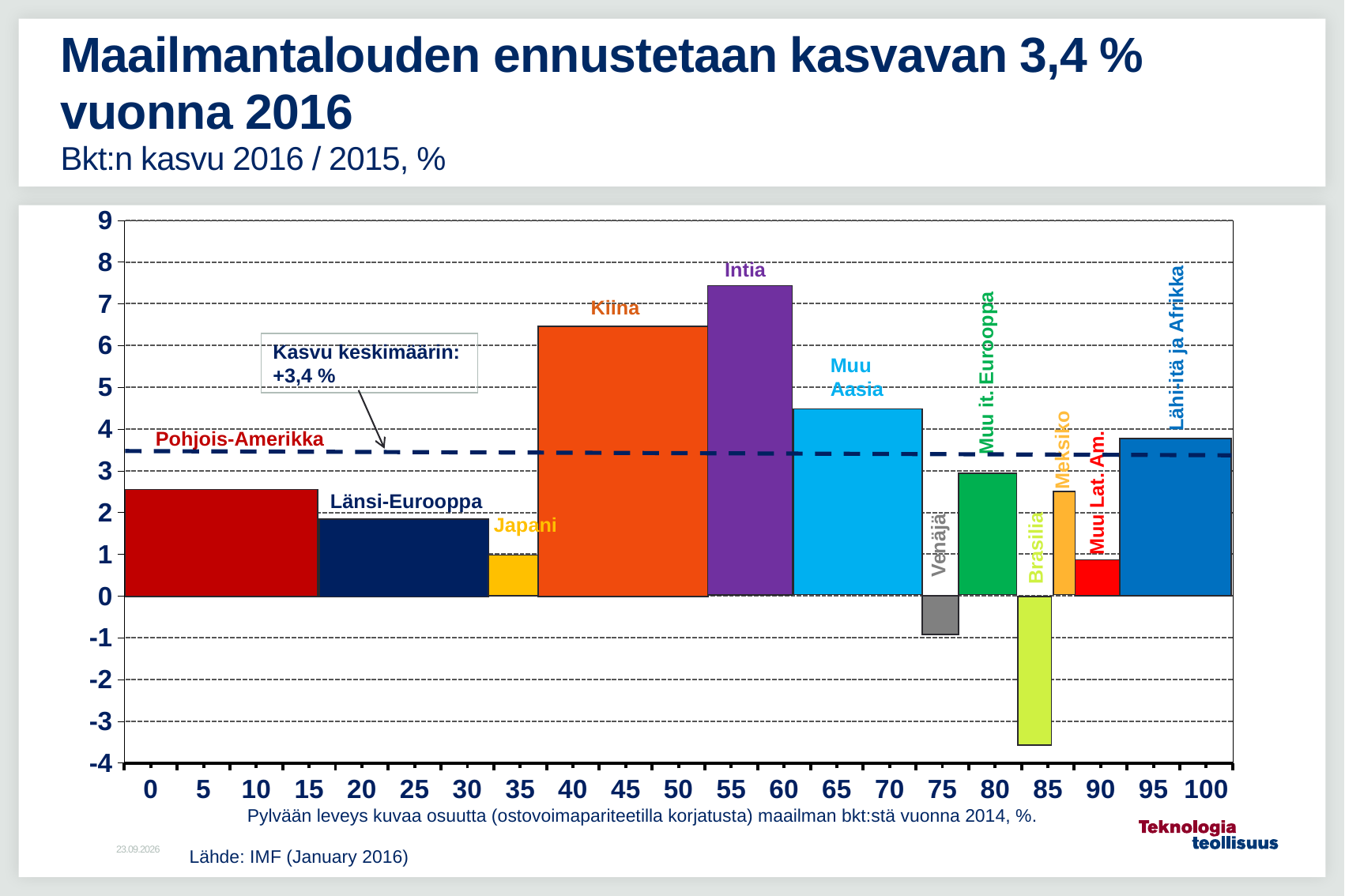
Is the value for Kiina greater or less than 6? greater Which has a higher growth forecast, Kiina or Intia? Intia Is the value for Venäjä greater or less than 0? less What kind of chart is shown on the slide? bar chart Is the value for Muu Aasia greater or less than 4? greater Which region has the lowest GDP growth forecast in the chart? Brasilia What average growth value is shown in the annotation box on the chart? +3,4 % Which region has the highest GDP growth forecast in the chart? Intia How many regions (bars) are shown in the chart? 12 Which has a higher growth forecast, Pohjois-Amerikka or Länsi-Eurooppa? Pohjois-Amerikka